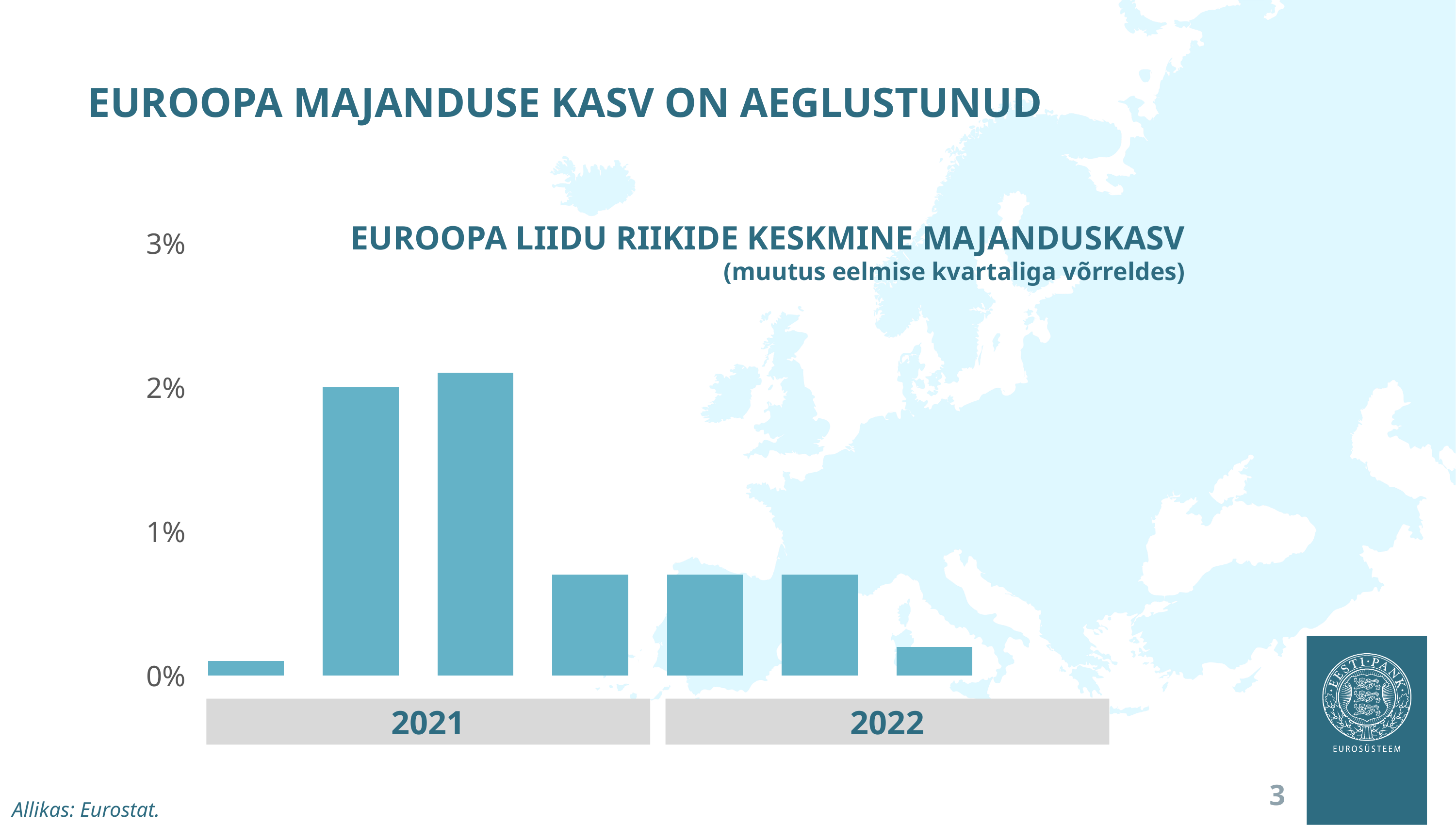
What is the title of the chart? EUROOPA LIIDU RIIKIDE KESKMINE MAJANDUSKASV How many bars are plotted for 2021? 4 Which is larger: the second bar in 2021 or the first bar in 2022? the second bar in 2021 How many bars are plotted in the chart? 7 Is the value of the first bar in 2021 greater or less than 1%? less Which year contains the tallest bar in the chart? 2021 What kind of chart is shown on the slide? bar chart How many bars are plotted for 2022? 3 Is the value of the last bar in 2022 greater or less than 1%? less Is the value of the second bar in 2021 greater or less than 1%? greater Which bar is the lowest in the chart? the first bar in 2021 What source is cited for the chart? Eurostat